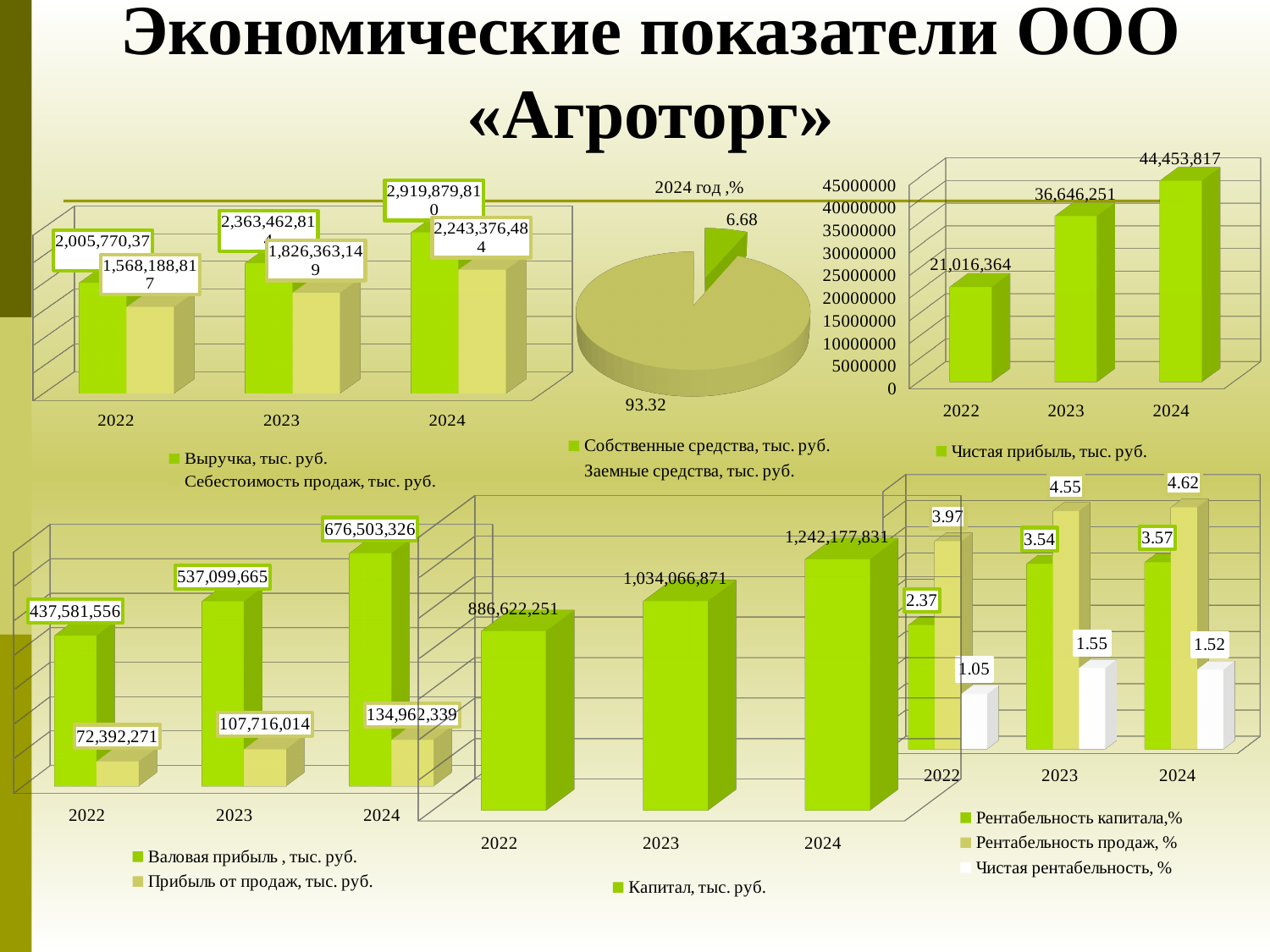
In the «Чистая прибыль, тыс. руб.» chart (top right), what is the value for 2023? 36,646,251 In the «Капитал, тыс. руб.» chart (bottom middle), how many years are shown? 3 In the chart titled «2024 год ,%», what is the value of the smaller slice? 6.68 In the chart titled «2024 год ,%», what is the value of the larger slice? 93.32 In the «Капитал, тыс. руб.» chart (bottom middle), what is the value for 2022? 886,622,251 In the chart titled «2024 год ,%», what kind of chart is it? pie chart In the «Чистая прибыль, тыс. руб.» chart (top right), do the values rise or fall from 2022 to 2024? rise In the bottom-right chart, how many series does the legend list? 3 In the «Чистая прибыль, тыс. руб.» chart (top right), which year has the highest value? 2024 In the bottom-left chart, what is the value of «Валовая прибыль, тыс. руб.» for 2024? 676,503,326 In the bottom-left chart, what is the value of «Прибыль от продаж, тыс. руб.» for 2022? 72,392,271 In the bottom-right chart, what is the value of «Рентабельность продаж, %» for 2023? 4.55